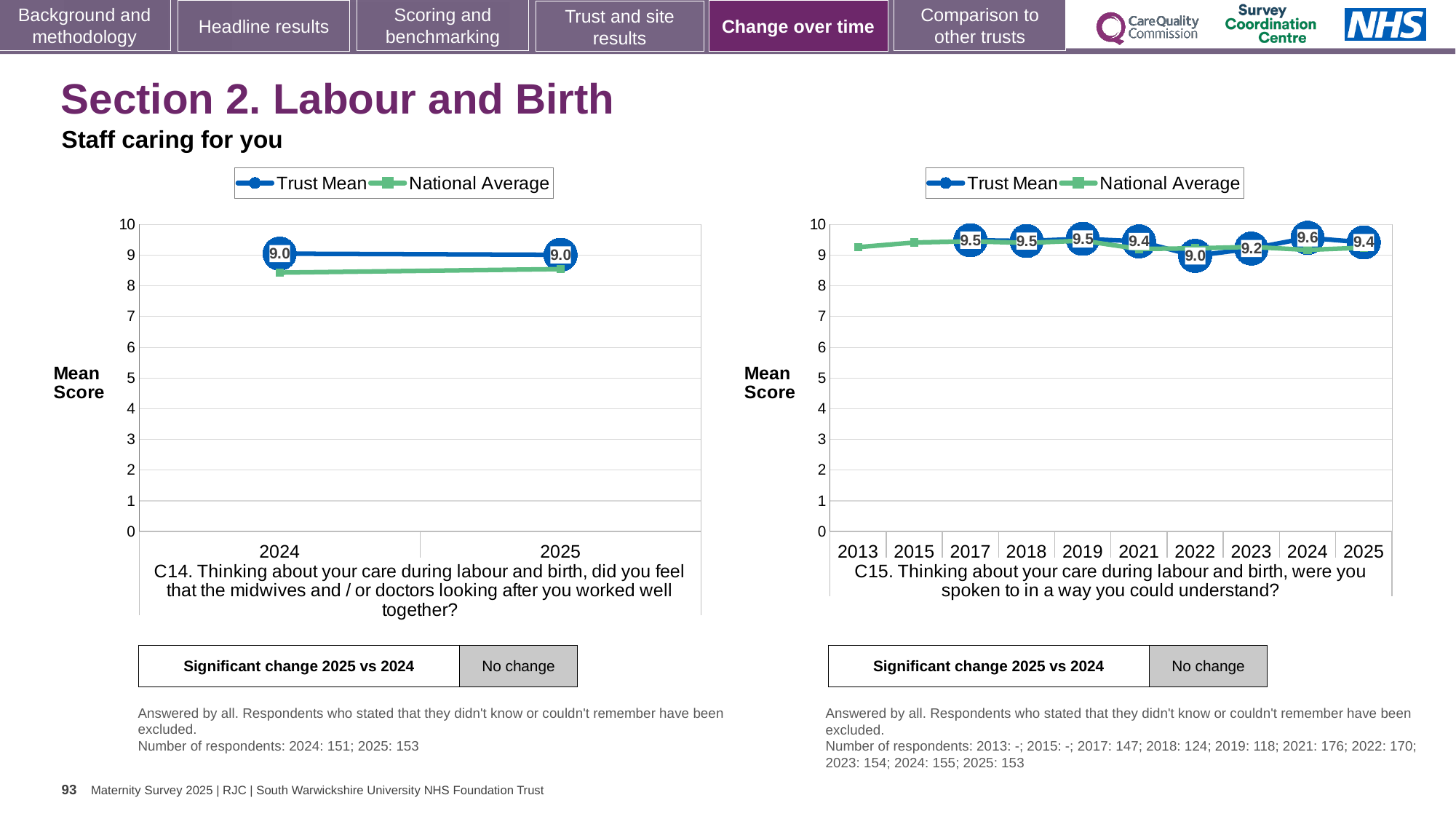
In the C15 chart on the right, which year has the lowest labelled Trust Mean? 2022 In the C15 chart on the right, what is the difference between the Trust Mean for 2024 and 2022? 0.6 In the C15 chart on the right, is the Trust Mean for 2023 larger or smaller than for 2025? smaller In the C14 chart on the left, what is the Trust Mean for 2024? 9.0 In the C14 chart on the left, is the National Average for 2024 greater or less than 9? less In the C15 chart on the right, what is the Trust Mean for 2024? 9.6 In the C15 chart on the right, which year has the highest Trust Mean? 2024 How many years are shown on the x axis of the C15 chart on the right? 10 In the C14 chart on the left, what is the Trust Mean for 2025? 9.0 How many series does the legend of the C14 chart on the left list? 2 In the C15 chart on the right, what is the Trust Mean for 2022? 9.0 What kind of chart is the C15 chart on the right? Line chart